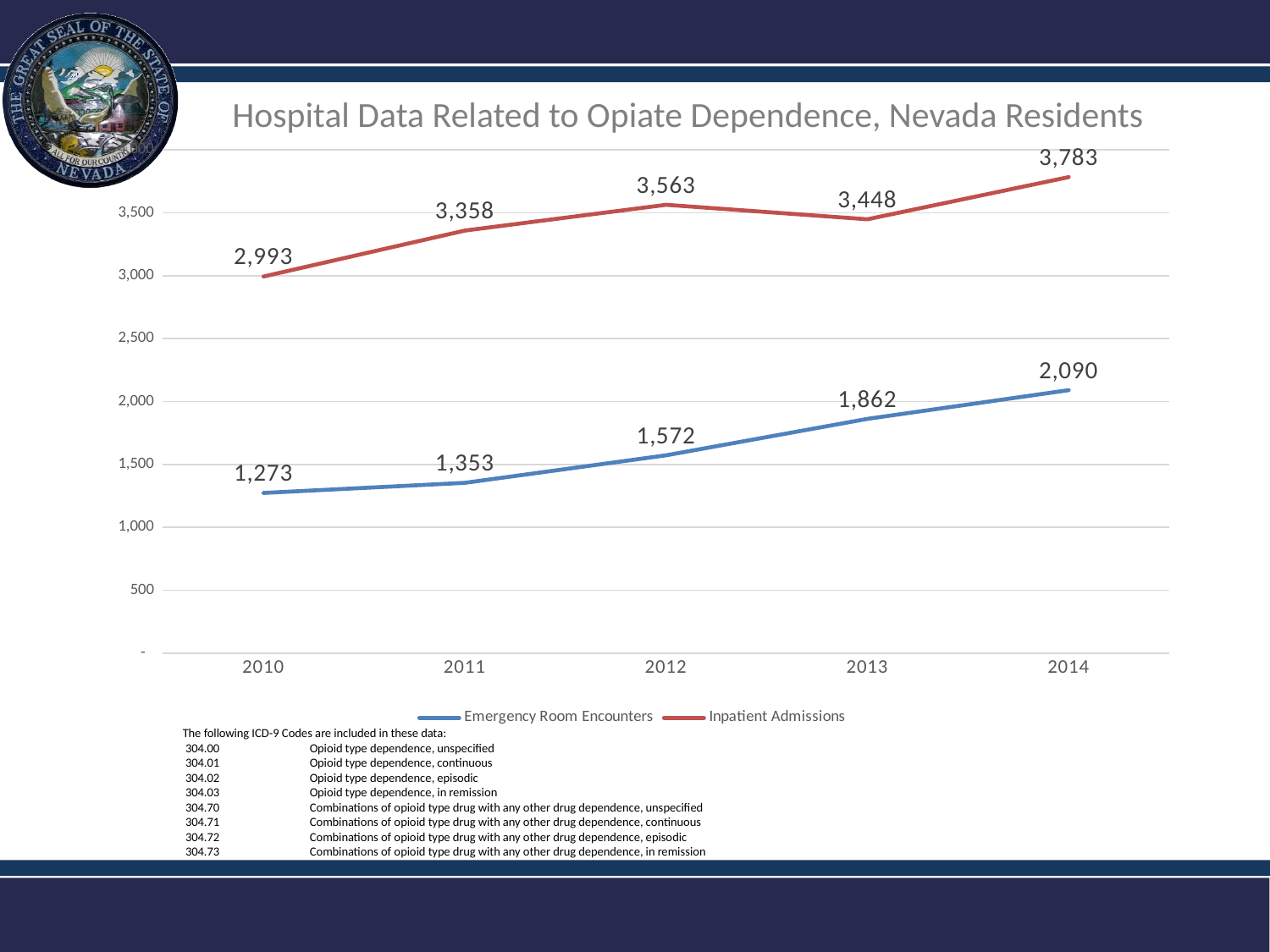
What is the title of the chart? Hospital Data Related to Opiate Dependence, Nevada Residents What was the number of Emergency Room Encounters in 2010? 1,273 Which was larger in 2013: Inpatient Admissions in 2013 or Inpatient Admissions in 2012? Inpatient Admissions in 2012 What was the number of Inpatient Admissions in 2012? 3,563 What kind of chart is shown on the slide? Line chart By how much did Emergency Room Encounters increase from 2010 to 2014? 817 How many series does the legend list? 2 What is the difference between Inpatient Admissions and Emergency Room Encounters in 2013? 1,586 In which year were Emergency Room Encounters lowest? 2010 How many years are shown on the x axis? 5 What was the number of Emergency Room Encounters in 2014? 2,090 In which year were Inpatient Admissions highest? 2014